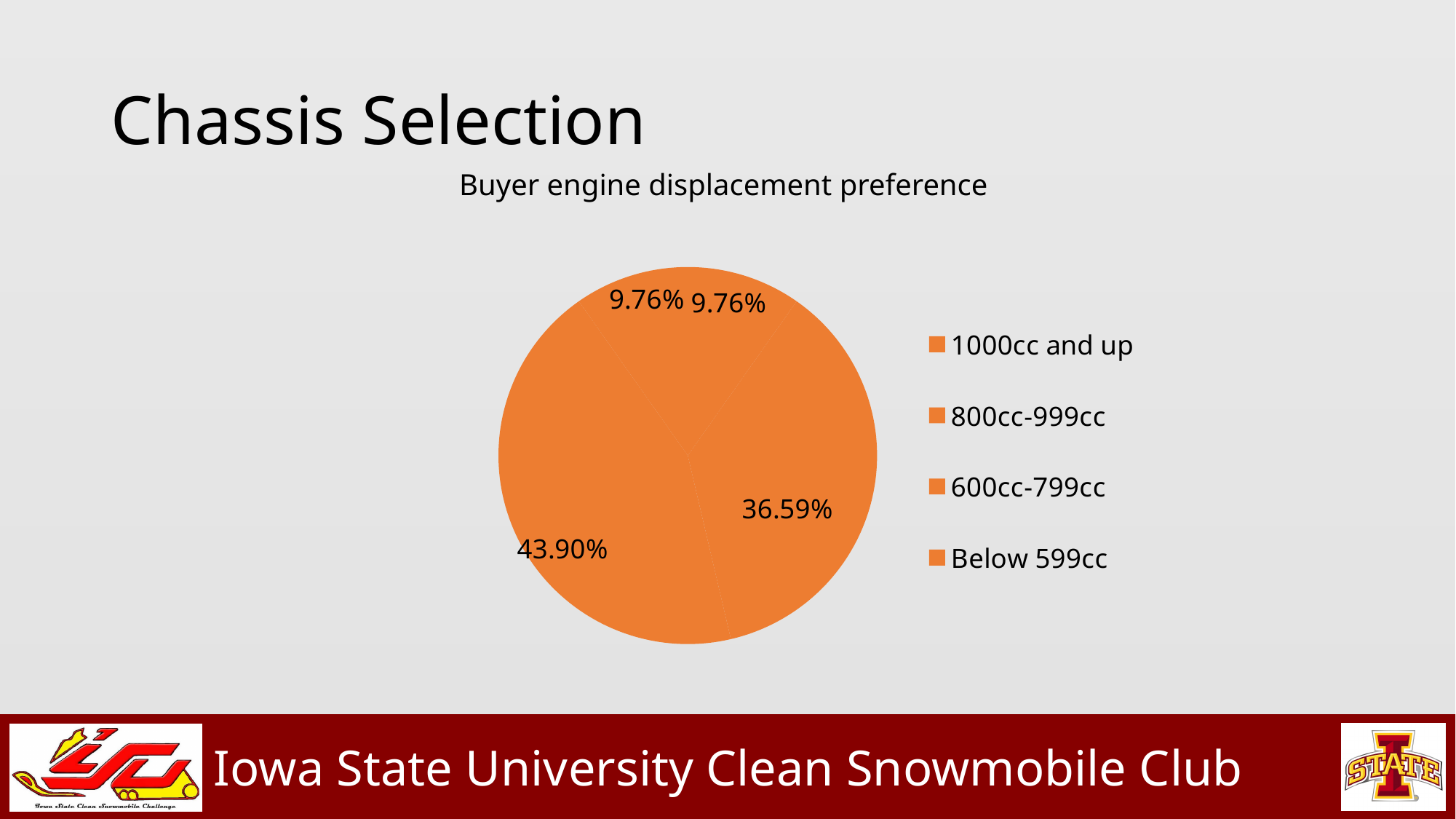
How many slices does the pie chart have? 4 What is the smallest percentage shown on the pie chart? 9.76% What kind of chart is shown on the slide? pie chart Which is larger, the slice labelled 36.59% or the slice labelled 43.90%? 43.90% What is the title of the chart? Buyer engine displacement preference What is the second-largest percentage shown on the pie chart? 36.59% How many categories does the legend of the pie chart list? 4 What is the difference between the largest slice (43.90%) and a 9.76% slice? 34.14% How many slices of the pie chart are labelled 9.76%? 2 What is the first category listed in the legend of the pie chart? 1000cc and up What is the difference between the largest slice (43.90%) and the second-largest slice (36.59%)? 7.31% What is the largest percentage shown on the pie chart? 43.90%